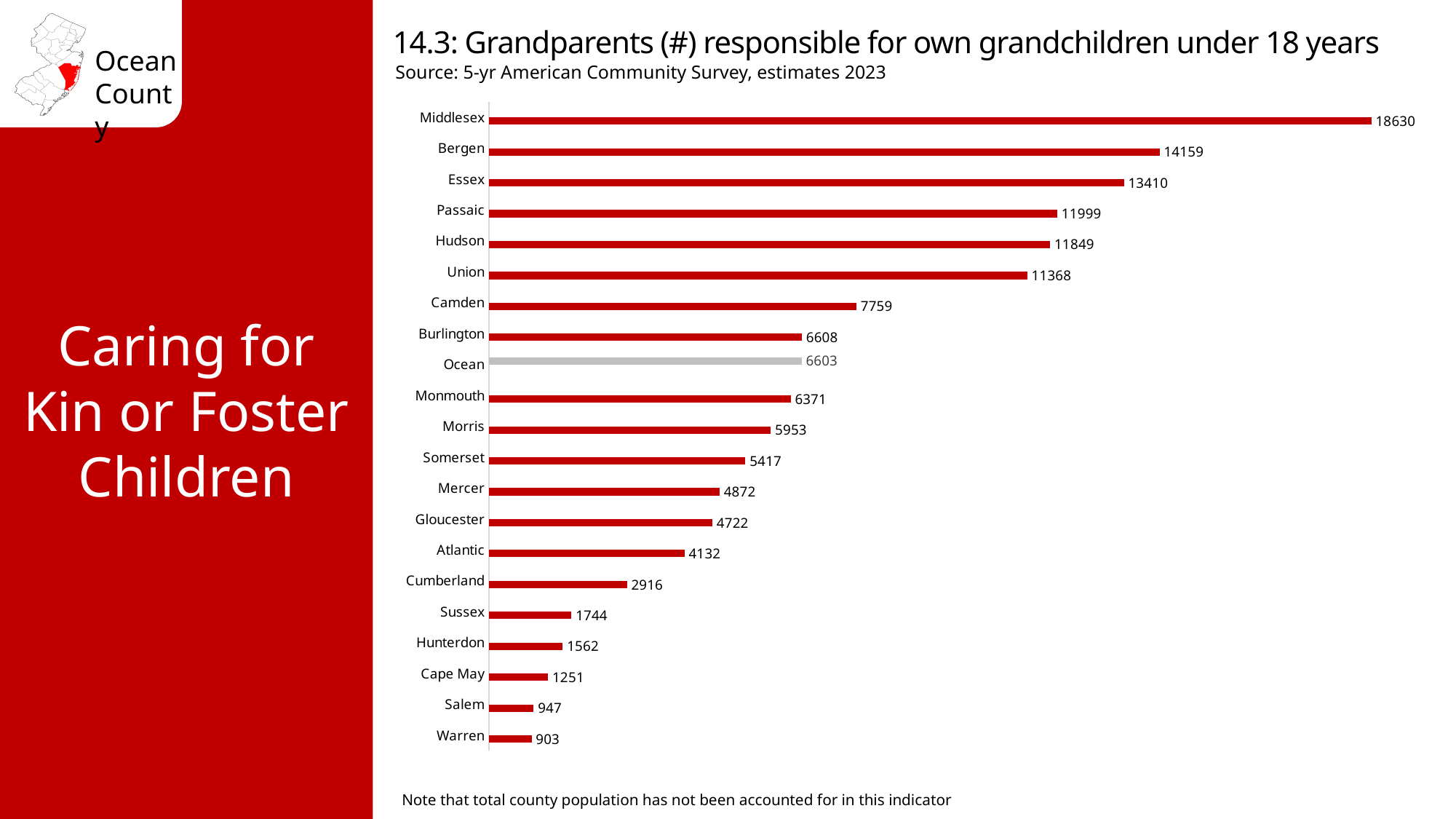
Which county has the lowest value? Warren What is the difference between the values for Ocean and Monmouth? 232 Which county has the highest value? Middlesex Which has a larger value, Essex or Passaic? Essex What is the value for Ocean County? 6603 What is the difference between the values for Middlesex and Bergen? 4471 What is the value for Cape May? 1251 Which has a larger value, Atlantic or Cumberland? Atlantic What kind of chart is shown on the slide? Bar chart What is the value for Camden? 7759 Which county's bar is shown in grey instead of red? Ocean How many counties are shown in the chart? 21